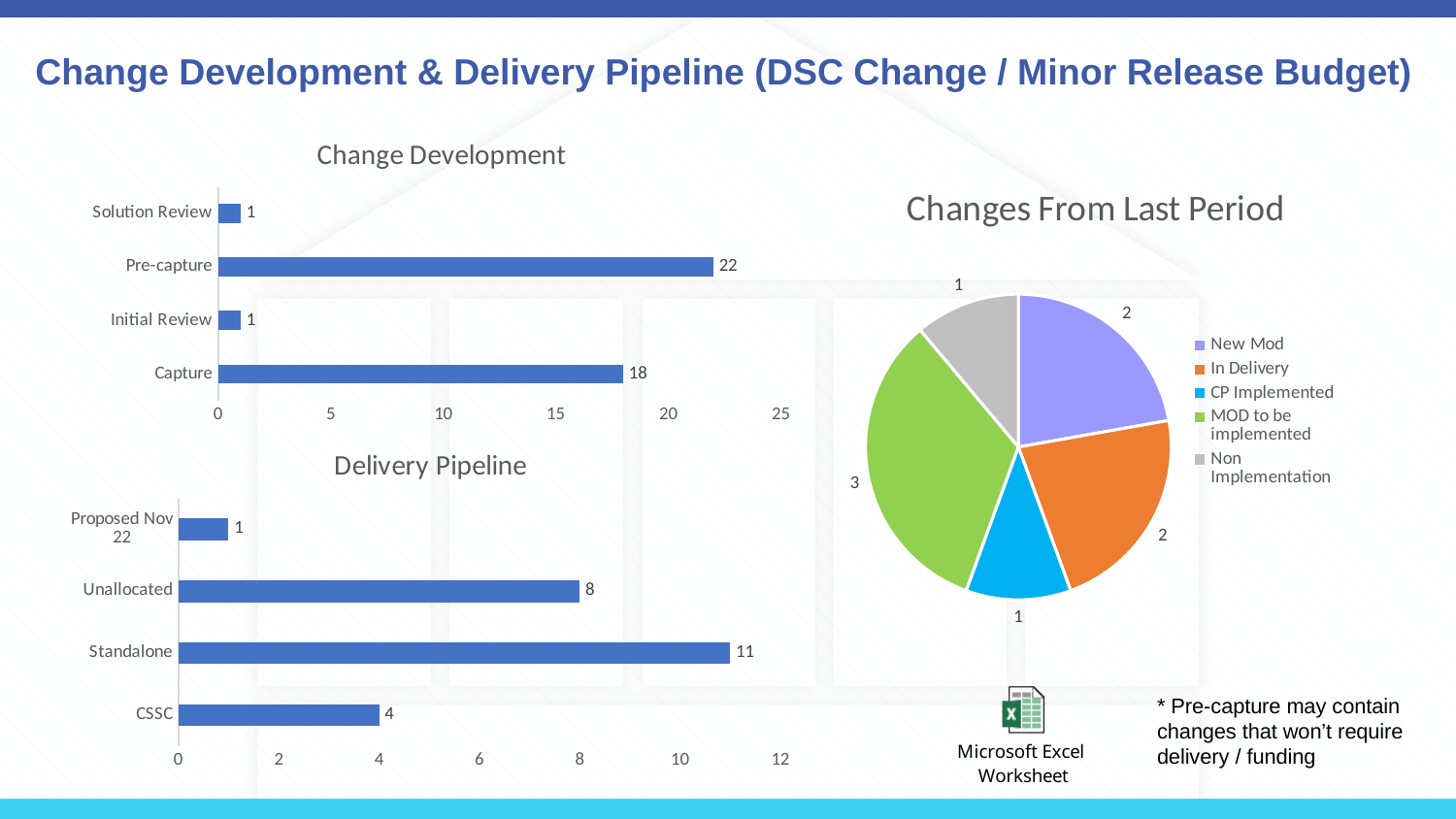
In the Change Development chart, how many categories are shown? 4 In the Changes From Last Period pie chart, what is the value for MOD to be implemented? 3 In the Delivery Pipeline chart, what is the difference between Standalone and Unallocated? 3 In the Delivery Pipeline chart, which is larger, Unallocated or CSSC? Unallocated What kind of chart is the Delivery Pipeline chart? Bar chart In the Change Development chart, what is the value for Pre-capture? 22 In the Delivery Pipeline chart, what is the value for Standalone? 11 How many series does the legend of the Changes From Last Period pie chart list? 5 In the Changes From Last Period pie chart, what is the total of all slices? 9 In the Delivery Pipeline chart, which category has the lowest value? Proposed Nov 22 In the Change Development chart, what is the difference between Pre-capture and Capture? 4 In the Change Development chart, which category has the highest value? Pre-capture